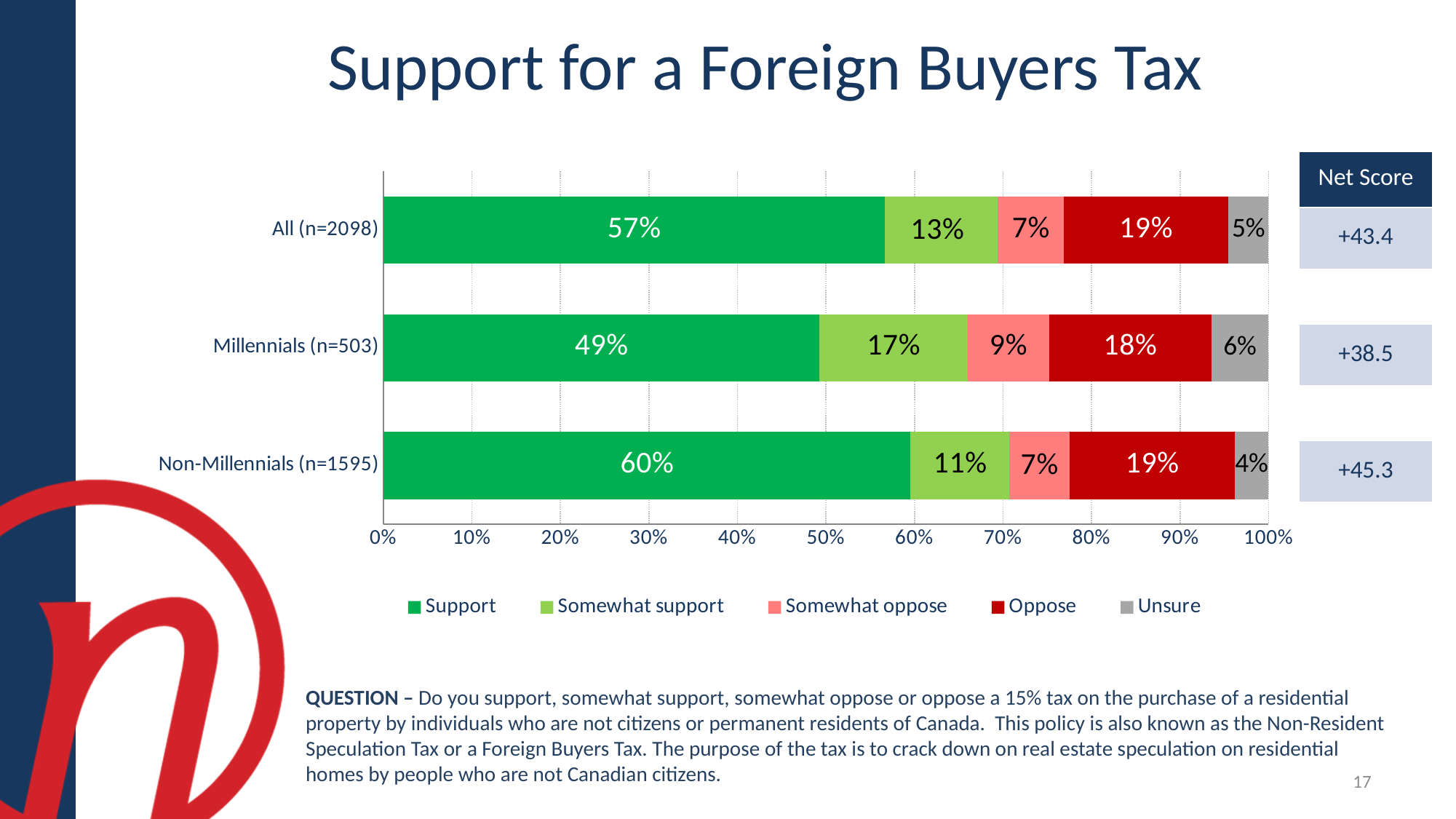
How many groups are shown on the chart? 3 What percentage of All (n=2098) respondents chose Support? 57% Which group has the highest Support percentage? Non-Millennials (n=1595) Which group has the lowest Support percentage? Millennials (n=503) What is the Net Score shown for Non-Millennials (n=1595)? +45.3 Which is larger: the Somewhat oppose share for Millennials (n=503) or for All (n=2098)? Millennials (n=503) What percentage of Millennials (n=503) chose Somewhat support? 17% How many series does the legend list? 5 What percentage of Non-Millennials (n=1595) chose Oppose? 19% What percentage of Millennials (n=503) were Unsure? 6% What kind of chart is shown on the slide? Stacked bar chart What is the difference in Support percentage between Non-Millennials (n=1595) and Millennials (n=503)? 11%